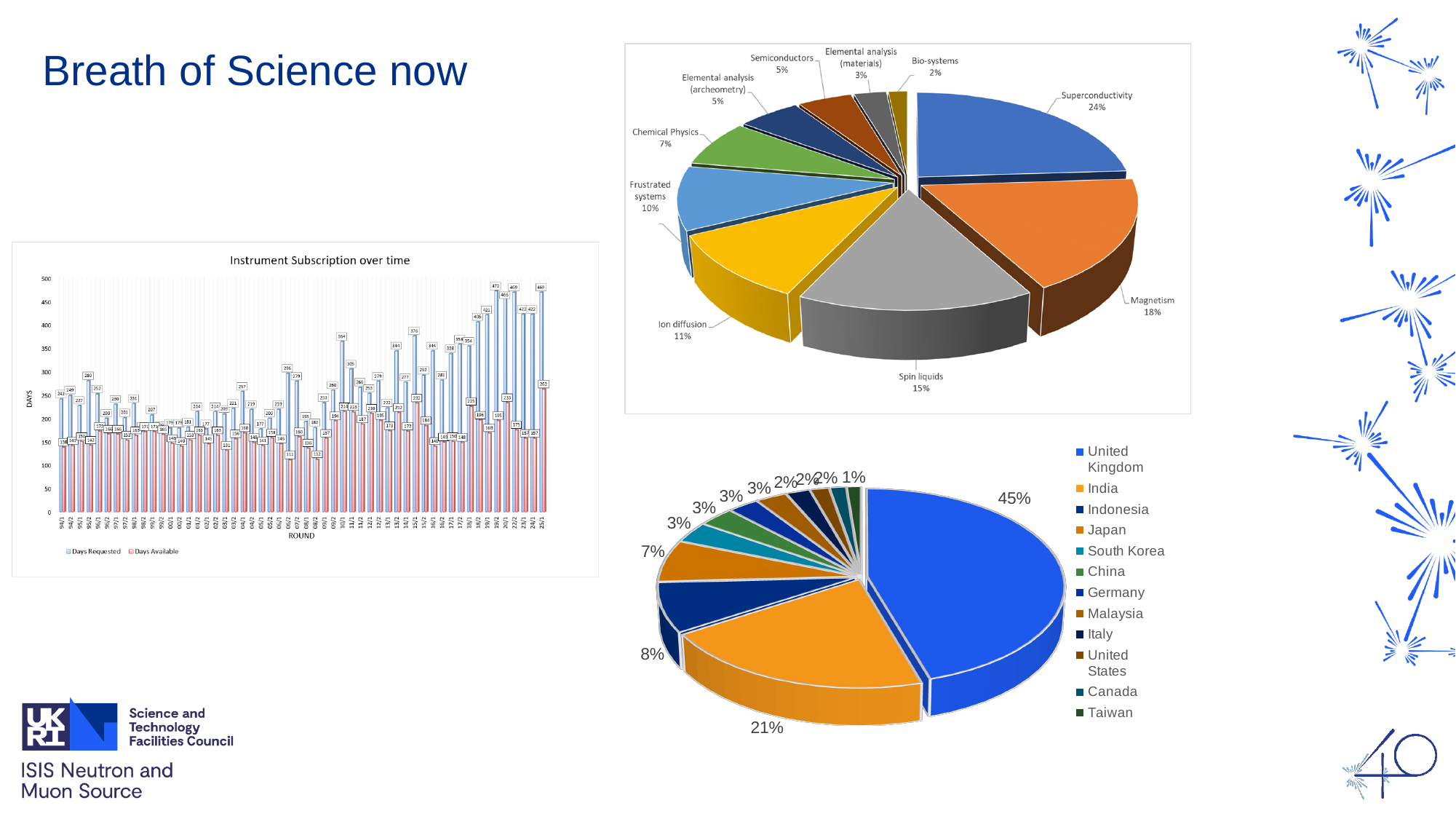
How many series does the legend of the 'Instrument Subscription over time' chart list? 2 What type of chart is the 'Instrument Subscription over time' chart on the left? bar chart In the bottom-right pie chart, which is larger, the share for Indonesia or the share for Japan? Indonesia In the top-right pie chart, which category has the smallest share? Bio-systems In the top-right pie chart, what share does Superconductivity have? 24% In the bottom-right pie chart, what share does India have? 21% In the top-right pie chart, what is the difference in percentage points between Magnetism and Ion diffusion? 7 How many countries does the legend of the bottom-right pie chart list? 12 In the top-right pie chart, what share does Spin liquids have? 15% In the top-right pie chart, which category has the largest share? Superconductivity In the bottom-right pie chart, what share does the United Kingdom have? 45% How many slices does the top-right pie chart have? 10